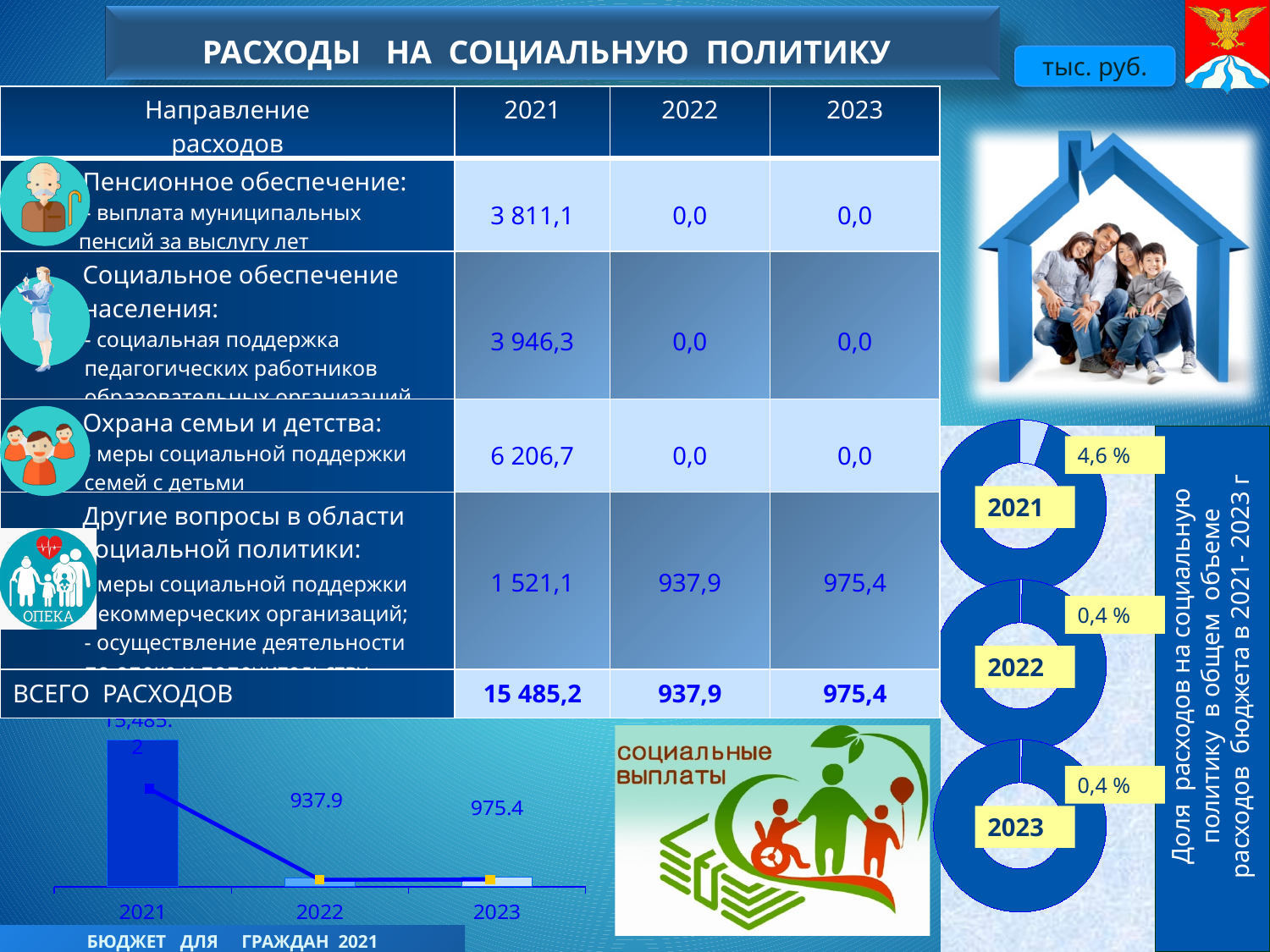
In the donut charts on the right of the slide, what share is shown for 2023? 0,4 % In the bar chart at the bottom left of the slide, which year has the highest value? 2021 In the donut charts on the right of the slide, what share is shown for 2021? 4,6 % In the bar chart at the bottom left of the slide, what is the difference between the values for 2023 and 2022? 37.5 In the bar chart at the bottom left of the slide, what value is labelled for 2023? 975.4 What kind of chart is shown at the bottom left of the slide? bar chart In the bar chart at the bottom left of the slide, which year has the lowest value? 2022 In the bar chart at the bottom left of the slide, which is larger: the value for 2022 or the value for 2023? 2023 Among the donut charts on the right of the slide, which year shows the largest share? 2021 In the bar chart at the bottom left of the slide, does the value rise or fall from 2021 to 2022? fall How many years are shown on the x axis of the bar chart at the bottom left of the slide? 3 In the bar chart at the bottom left of the slide, what value is labelled for 2022? 937.9